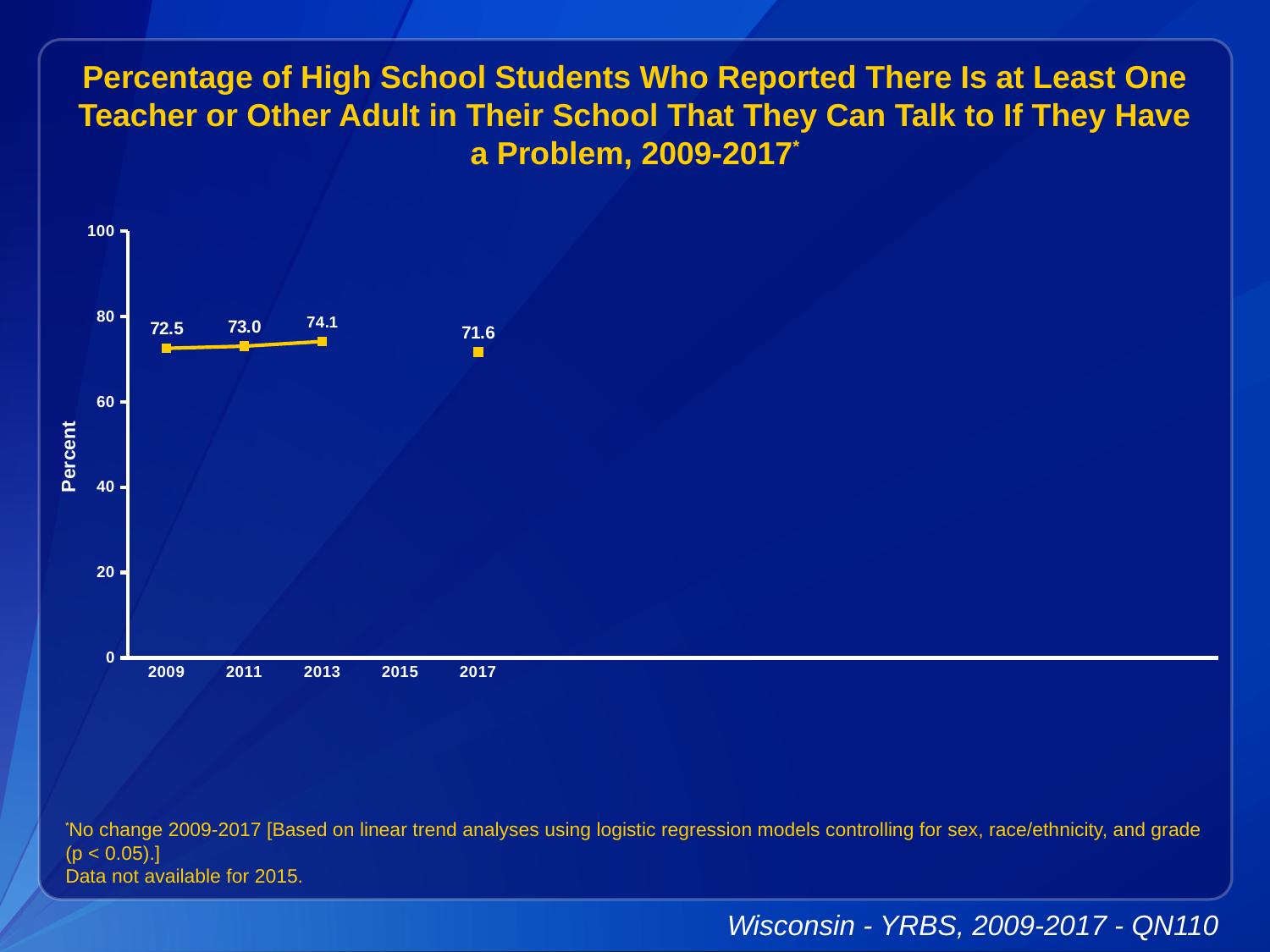
How many years have a plotted data point? 4 What is the value for 2009? 72.5 What is the value for 2013? 74.1 What is the difference between the values for 2013 and 2017? 2.5 Which is larger, the value for 2011 or the value for 2017? 2011 What is the value for 2017? 71.6 Is the value for 2009 greater or less than 80? less What is the label on the y axis? Percent Which year has the highest value? 2013 What kind of chart is this? line chart Which year has the lowest value? 2017 Do the values rise or fall from 2009 to 2013? rise